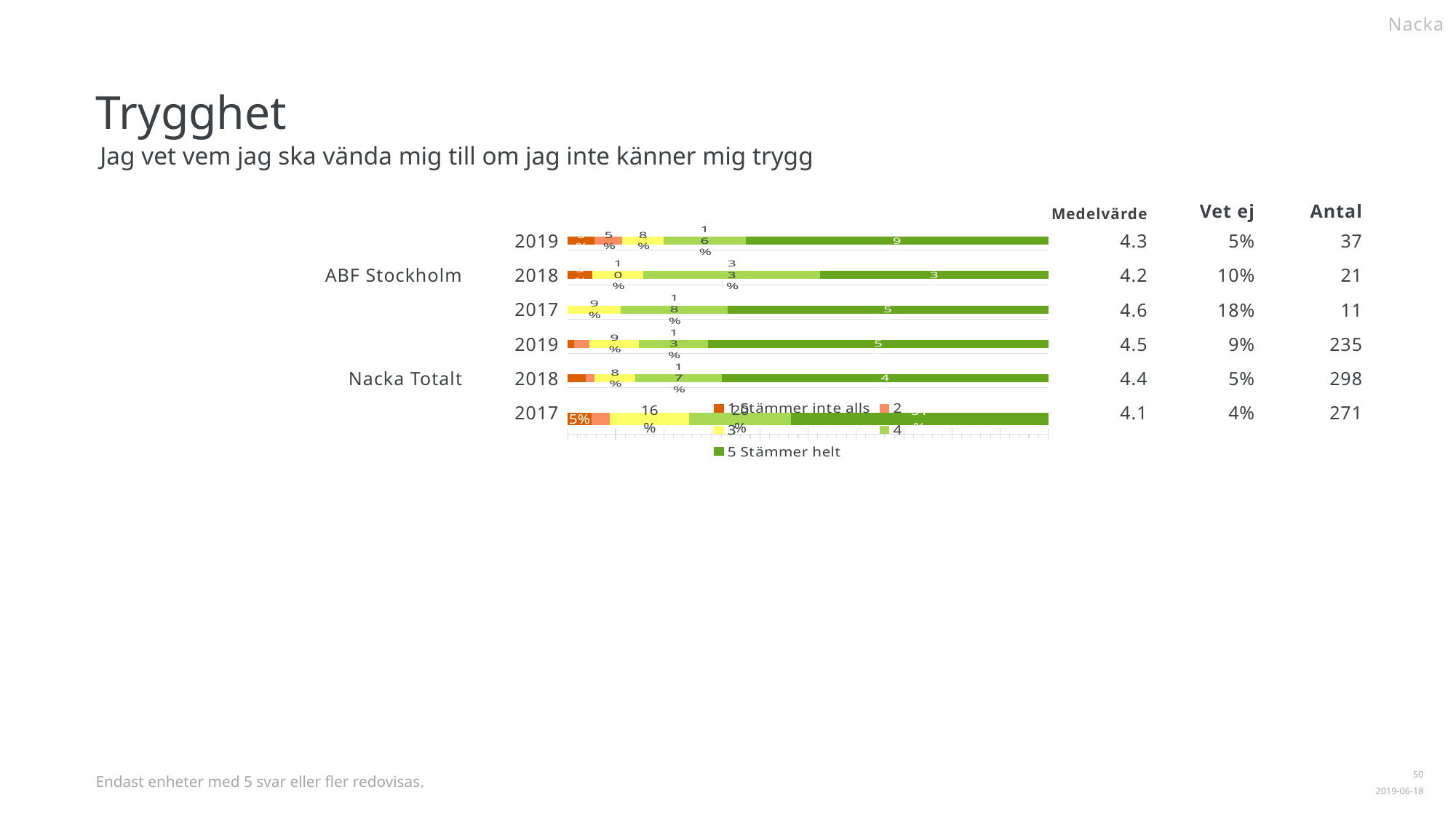
What is the value of the '1 Stämmer inte alls' segment for Nacka Totalt 2017? 5% How many bars are plotted in the chart? 6 Which segment is the largest in the Nacka Totalt 2017 bar? 5 Stämmer helt What is the first entry in the chart legend? 1 Stämmer inte alls What kind of chart is shown on the slide? Stacked bar chart In the Nacka Totalt 2017 bar, which is larger: the '3' segment or the '1 Stämmer inte alls' segment? 3 What is the Medelvärde shown for ABF Stockholm 2019? 4.3 Which row has the highest Medelvärde? ABF Stockholm 2017 What is the Antal shown for Nacka Totalt 2018? 298 What is the last entry in the chart legend? 5 Stämmer helt How many series does the chart legend list? 5 What is the value of the '3' segment for Nacka Totalt 2017? 16%